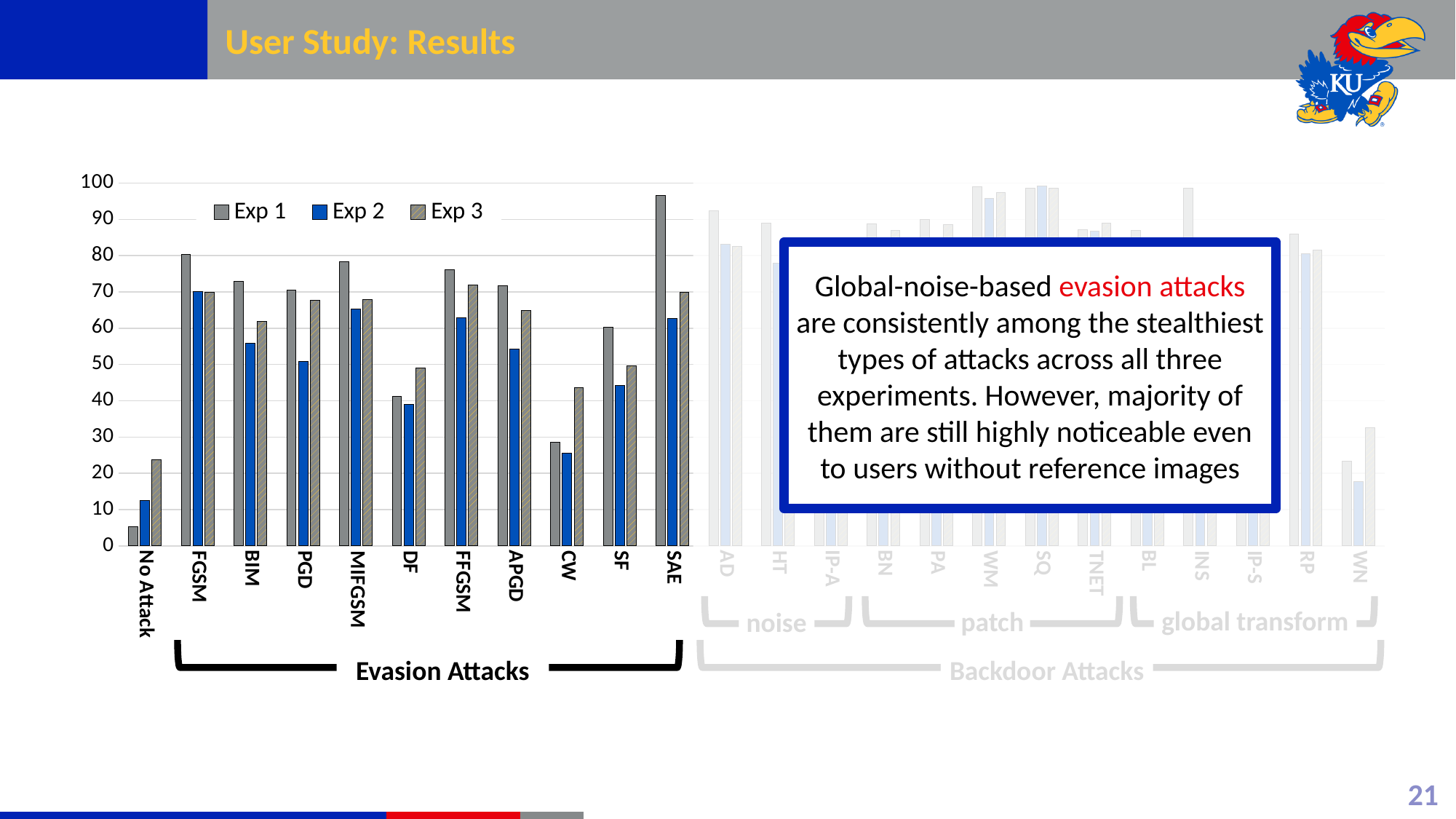
For CW, which is larger: the Exp 2 value or the Exp 3 value? Exp 3 Is the Exp 2 value for DF greater or less than 50? less How many categories are grouped under the Evasion Attacks bracket? 10 What are the entries in the chart's legend? Exp 1, Exp 2, Exp 3 Among the categories from No Attack to SAE, which has the lowest Exp 2 value? No Attack Which series is drawn in blue? Exp 2 Among the categories from No Attack to SAE, which has the lowest Exp 1 value? No Attack Is the Exp 1 value for FGSM greater or less than 70? greater What kind of chart is shown on the slide? bar chart Among the categories from No Attack to SAE, which has the highest Exp 1 value? SAE Is the Exp 1 value for SAE greater or less than 90? greater How many series does the chart's legend list? 3